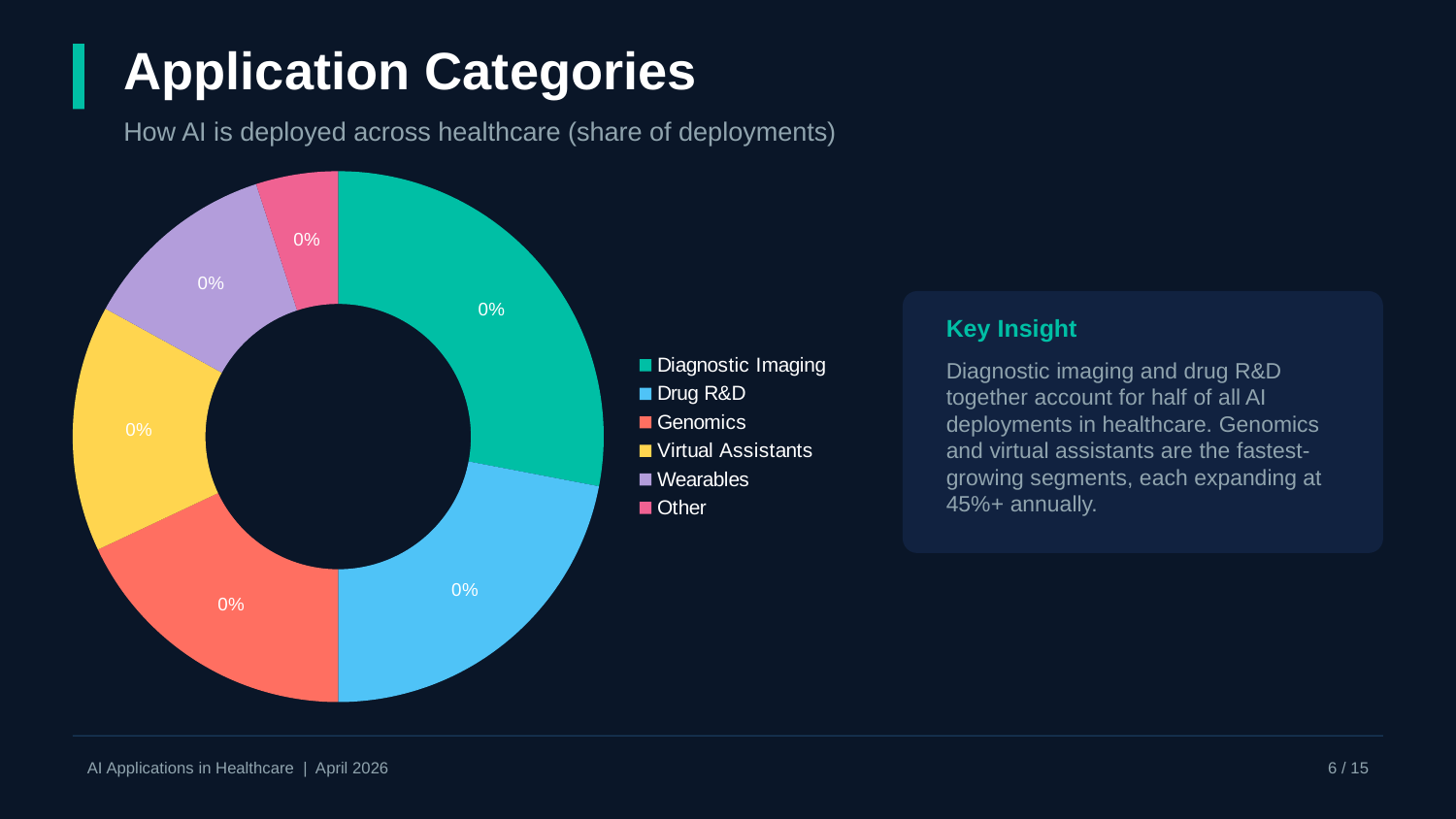
Which slice is larger, Genomics or Other? Genomics Which slice is larger, Virtual Assistants or Other? Virtual Assistants Which category is shown in pink in the chart legend? Other How many slices does the donut chart have? 6 What data label is printed on the Diagnostic Imaging slice? 0% Which category has the smallest slice in the chart? Other Which slice is larger, Diagnostic Imaging or Wearables? Diagnostic Imaging Which category has the largest slice in the chart? Diagnostic Imaging What kind of chart is shown on the slide? Donut (pie) chart What is the subtitle shown above the chart? How AI is deployed across healthcare (share of deployments) How many categories does the legend of the chart list? 6